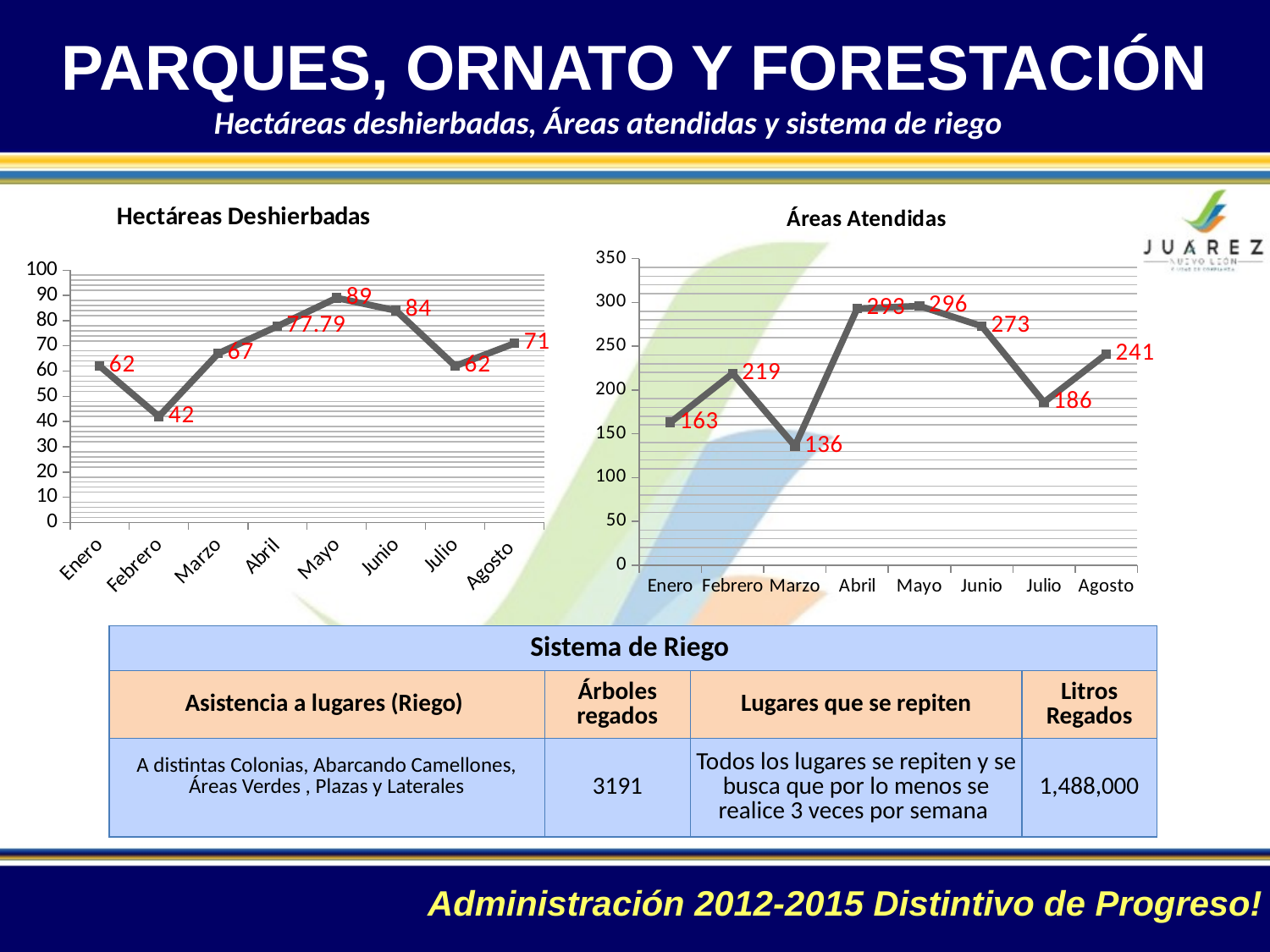
In the Áreas Atendidas chart, is the value for Junio larger than the value for Agosto? Yes In the Hectáreas Deshierbadas chart, what is the difference between the values for Mayo and Febrero? 47 In the Áreas Atendidas chart, what is the value for Marzo? 136 In the Áreas Atendidas chart, which month has the lowest value? Marzo In the Áreas Atendidas chart, do the values rise or fall from Junio to Julio? Fall In the Áreas Atendidas chart, what is the difference between the values for Abril and Enero? 130 In the Hectáreas Deshierbadas chart, which month has the lowest value? Febrero In the Hectáreas Deshierbadas chart, what is the value for Abril? 77.79 In the Hectáreas Deshierbadas chart, how many months are plotted? 8 In the Áreas Atendidas chart, which month has the highest value? Mayo What kind of chart is the Hectáreas Deshierbadas chart? Line chart In the Hectáreas Deshierbadas chart, which month has the highest value? Mayo